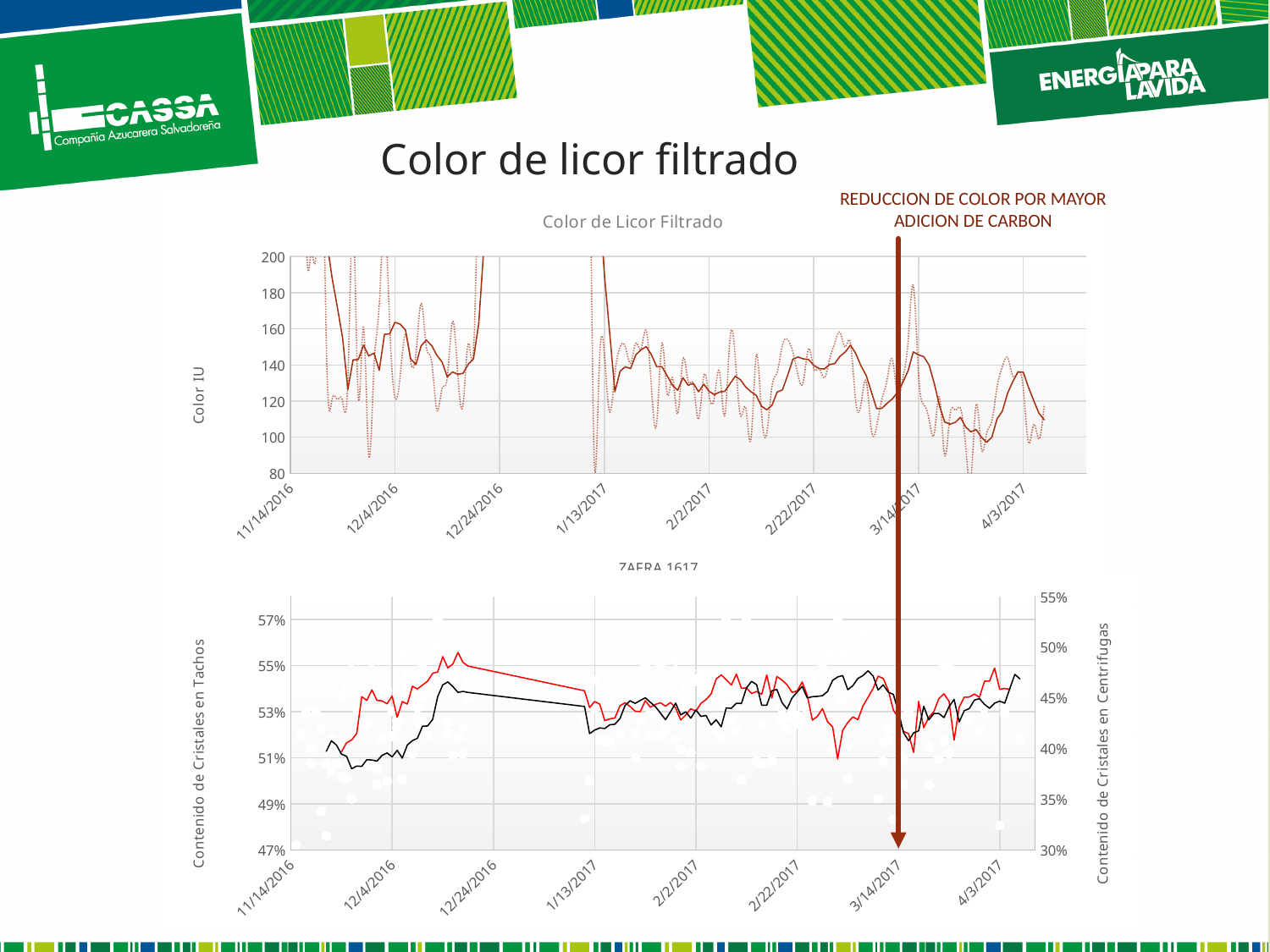
In the bottom chart, what is the label of the right vertical axis? Contenido de Cristales en Centrifugas In the bottom chart, is the black line's value at its last point (near 4/3/2017) greater or less than 51% on the left axis? greater In the top chart "Color de Licor Filtrado", is the solid line's value at 2/2/2017 greater or less than 100? greater What kind of chart is the bottom chart on the slide? line chart In the top chart "Color de Licor Filtrado", is the solid line's value at the last date (4/3/2017) greater or less than 140? less In the bottom chart, what is the label of the left vertical axis? Contenido de Cristales en Tachos How many charts are shown on the slide? 2 What kind of chart is the top chart titled "Color de Licor Filtrado"? line chart In the top chart "Color de Licor Filtrado", what is the highest value shown on the vertical axis? 200